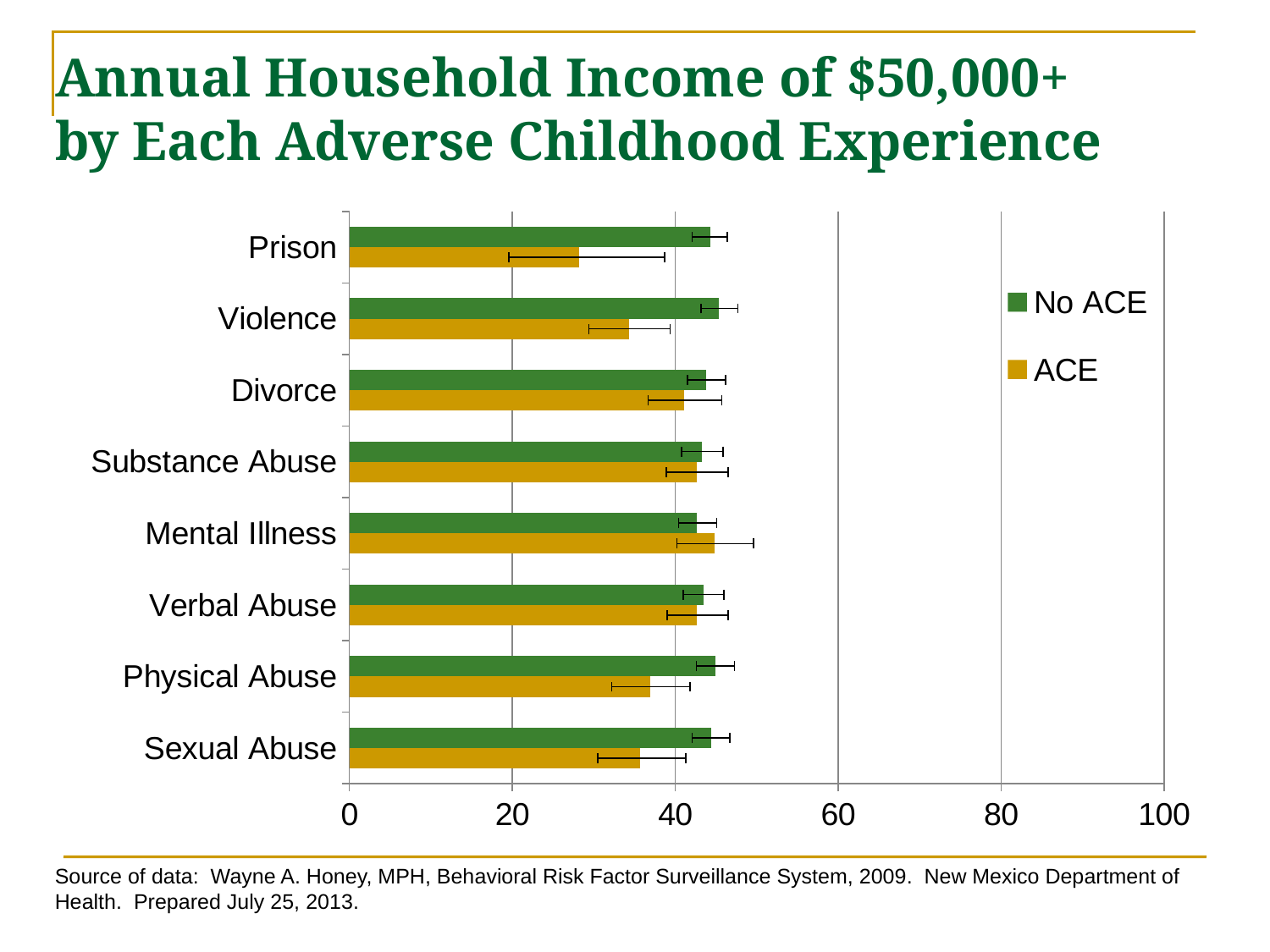
Is the ACE value for Prison greater or less than 20? greater For Violence, which series has the larger value, No ACE or ACE? No ACE Which category has the lowest value for the ACE series? Prison Is the ACE value for Physical Abuse greater or less than 40? less For Prison, which series has the larger value, No ACE or ACE? No ACE Is the ACE value for Prison greater or less than 40? less How many series does the legend list? 2 What kind of chart is shown on the slide? bar chart How many adverse childhood experience categories are shown on the chart? 8 What are the two series named in the legend? No ACE and ACE